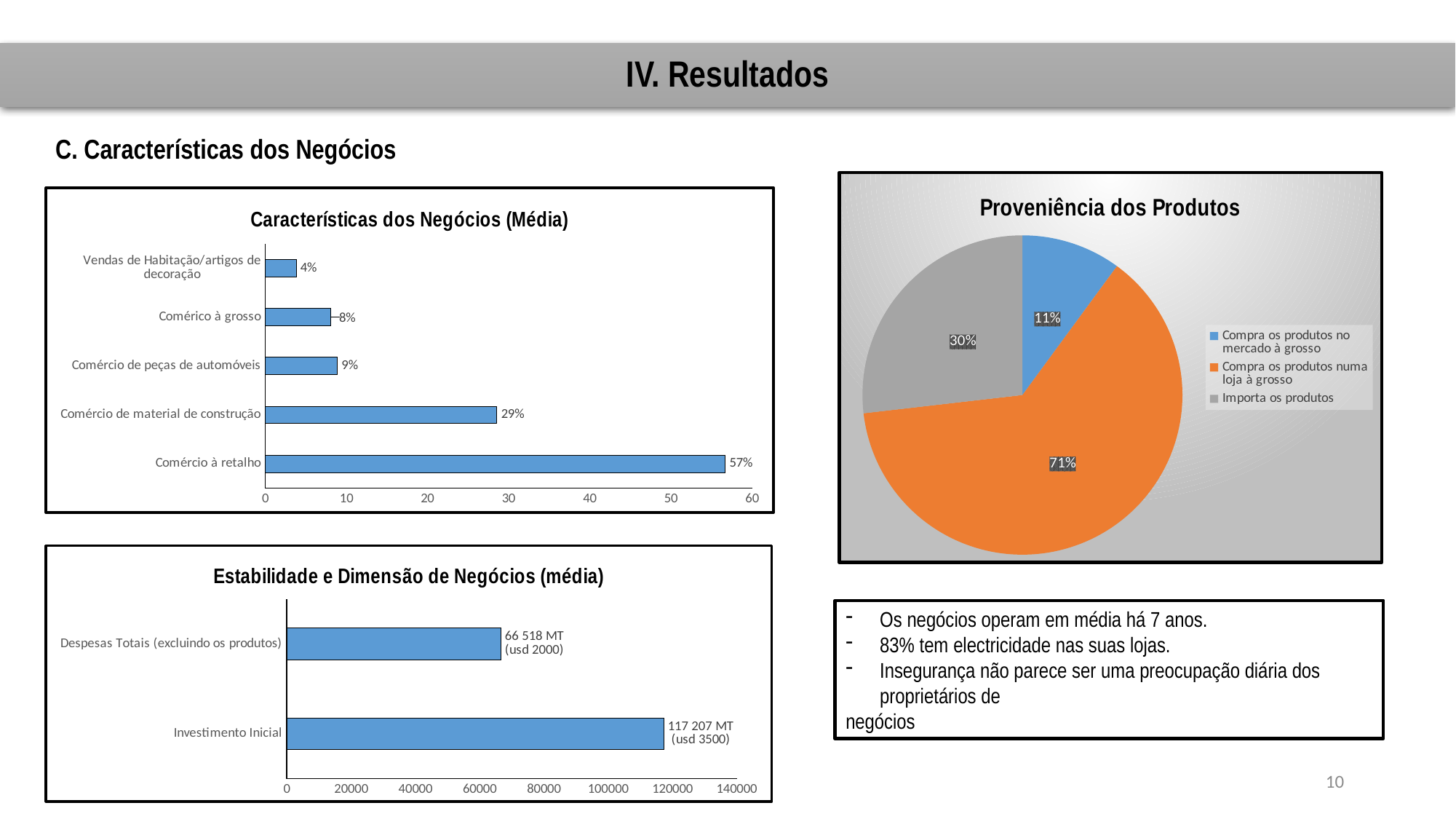
In the 'Proveniência dos Produtos' pie chart, what share corresponds to 'Compra os produtos numa loja à grosso'? 71% In the 'Características dos Negócios (Média)' chart, what is the value for Comércio à retalho? 57% How many entries does the legend of the 'Proveniência dos Produtos' pie chart list? 3 In the 'Características dos Negócios (Média)' chart, what is the difference between Comércio à retalho and Comércio de material de construção? 28% In the 'Estabilidade e Dimensão de Negócios (média)' chart, what is the value for Investimento Inicial? 117 207 MT What kind of chart is 'Estabilidade e Dimensão de Negócios (média)'? Bar chart In the 'Proveniência dos Produtos' pie chart, what share corresponds to 'Importa os produtos'? 30% In the 'Características dos Negócios (Média)' chart, what is the value for Comércio de material de construção? 29% In the 'Características dos Negócios (Média)' chart, which is larger: Comérico à grosso or Comércio de peças de automóveis? Comércio de peças de automóveis In the 'Estabilidade e Dimensão de Negócios (média)' chart, what is the value for Despesas Totais (excluindo os produtos)? 66 518 MT In the 'Características dos Negócios (Média)' chart, which category has the lowest value? Vendas de Habitação/artigos de decoração In the 'Características dos Negócios (Média)' chart, how many categories are shown? 5